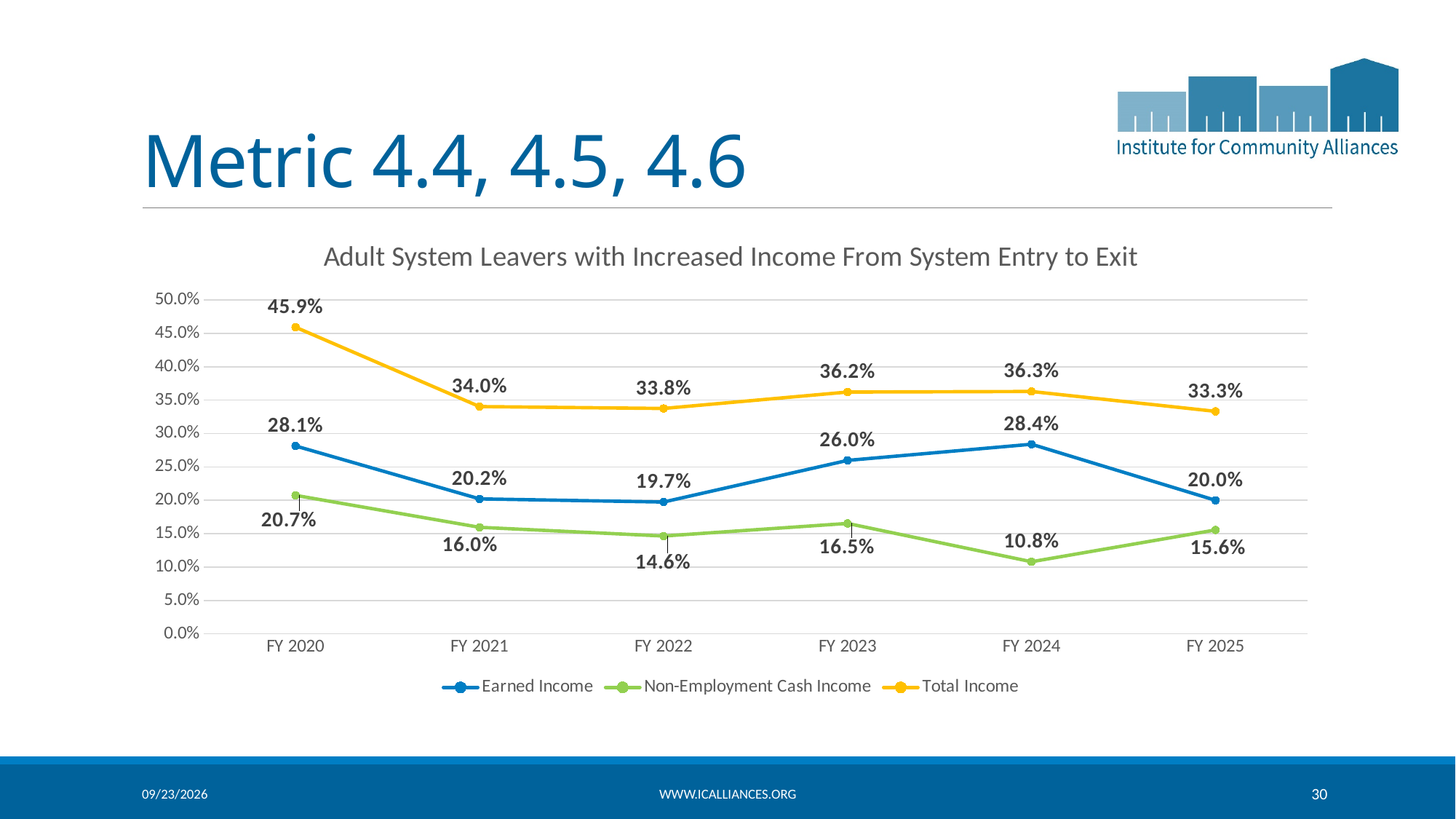
In which fiscal year is Non-Employment Cash Income lowest? FY 2024 What is the title of the chart? Adult System Leavers with Increased Income From System Entry to Exit What is the Non-Employment Cash Income value for FY 2022? 14.6% How many fiscal years are shown on the x axis? 6 Does Total Income rise or fall from FY 2020 to FY 2021? Fall How many series does the legend list? 3 In which fiscal year is Total Income highest? FY 2020 What is the Total Income value for FY 2020? 45.9% What is the Earned Income value for FY 2024? 28.4% Which is larger in FY 2023: Earned Income or Non-Employment Cash Income? Earned Income What is the difference between Total Income and Earned Income in FY 2025? 13.3% What kind of chart is shown on the slide? Line chart